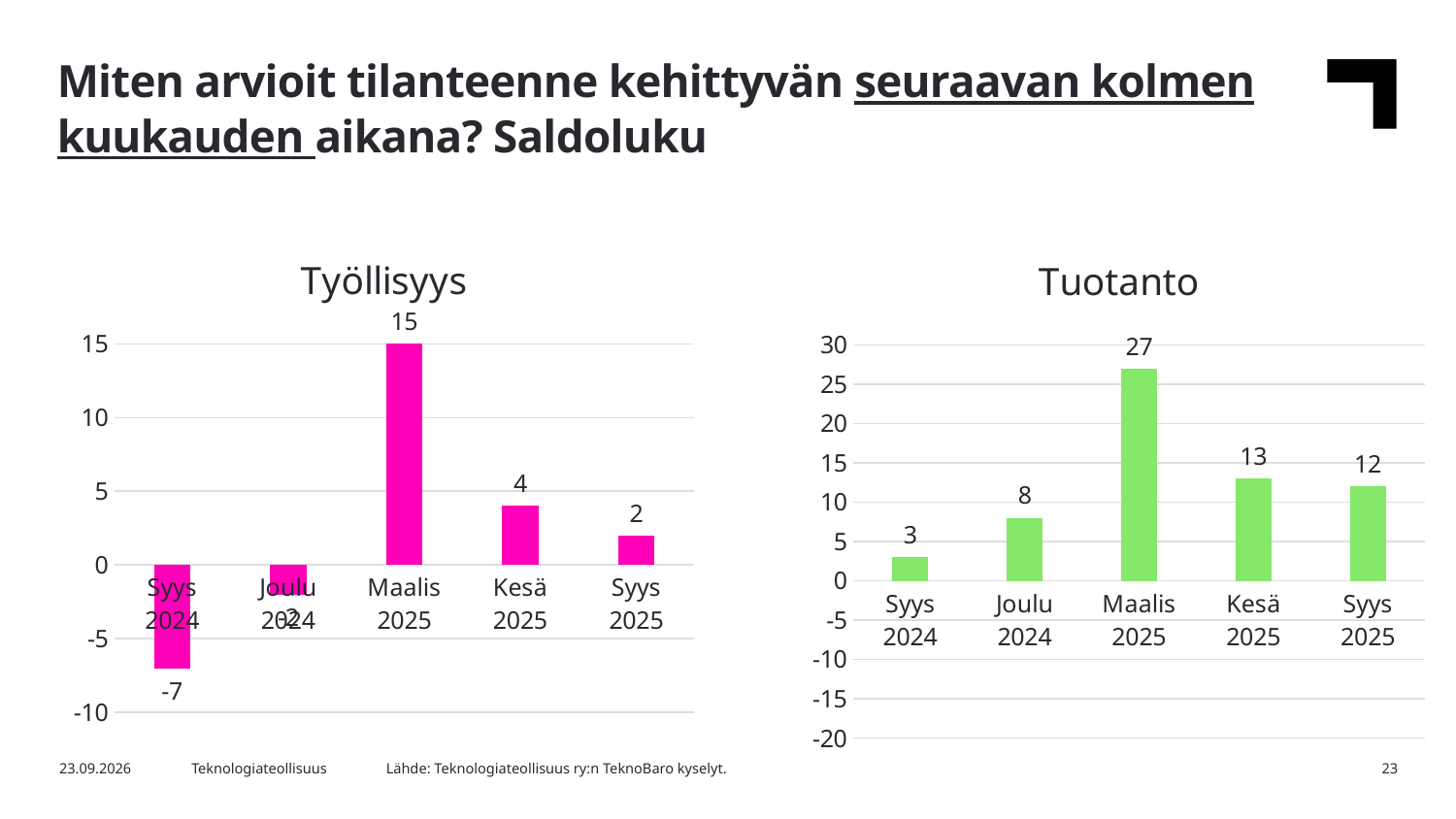
In the Työllisyys chart, what is the difference between the values for Maalis 2025 and Kesä 2025? 11 How many periods are shown on the x axis of the Tuotanto chart? 5 In the Tuotanto chart, which is larger, the value for Kesä 2025 or Syys 2025? Kesä 2025 In the Työllisyys chart, which period has the lowest value? Syys 2024 In the Tuotanto chart, which period has the highest value? Maalis 2025 In the Työllisyys chart, what is the value for Syys 2024? -7 In the Tuotanto chart, which period has the lowest value? Syys 2024 What kind of chart is the Työllisyys chart? bar chart In the Työllisyys chart, is the value for Joulu 2024 greater or less than 0? less In the Tuotanto chart, what is the value for Kesä 2025? 13 In the Työllisyys chart, what is the value for Maalis 2025? 15 In the Tuotanto chart, what is the difference between the values for Maalis 2025 and Joulu 2024? 19